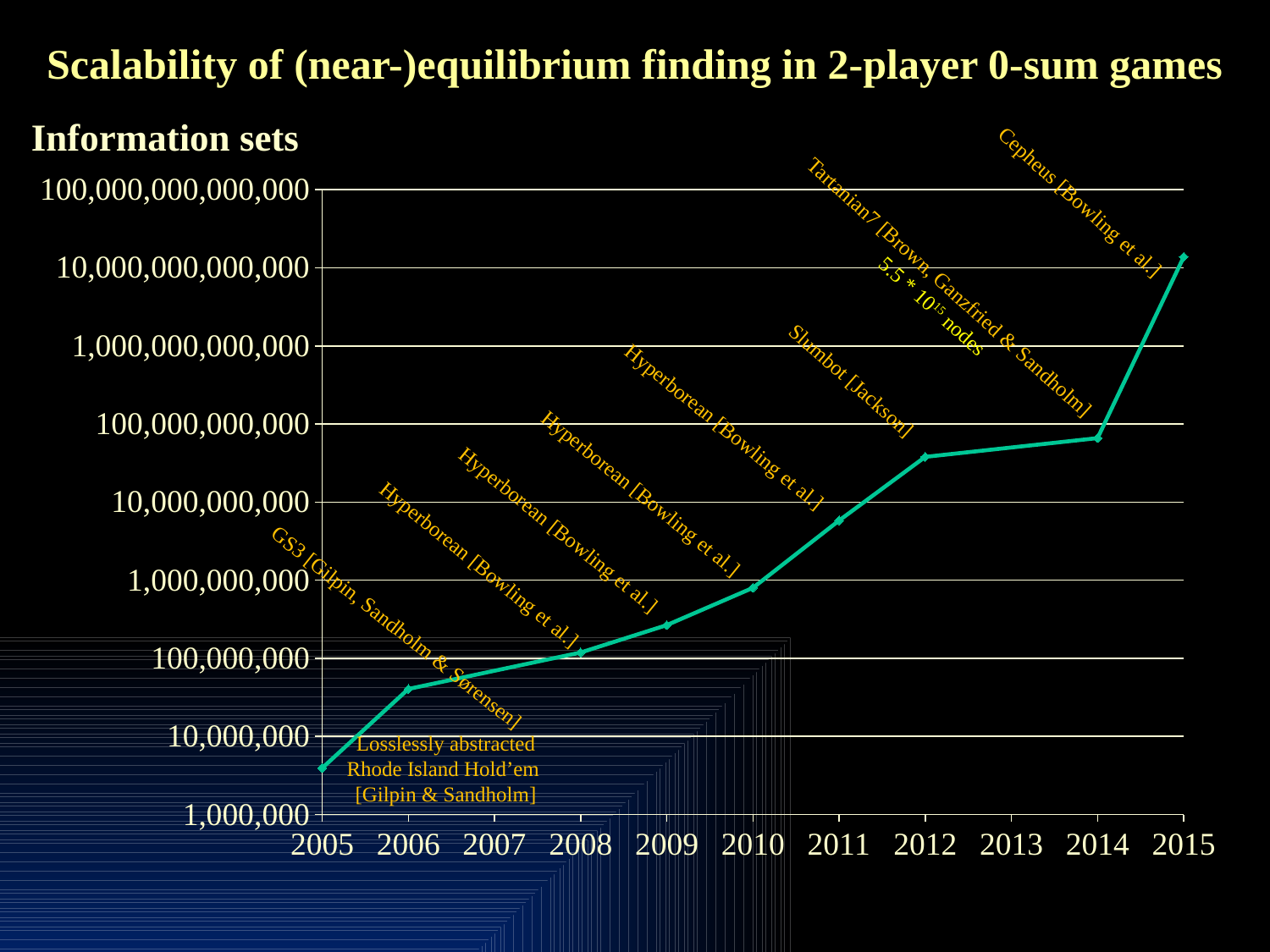
Which year has the lowest number of information sets? 2005 Is the value for 2006 greater or less than 100,000,000? less Is the value for 2009 greater or less than 100,000,000? greater What quantity is plotted on the y axis of the chart? Information sets Do the values generally rise or fall from 2005 to 2015? rise What kind of chart is shown on the slide? line chart Which year has the highest number of information sets? 2015 Which year has the larger value, 2009 or 2012? 2012 Is the value for 2005 greater or less than 10,000,000? less What is the title of the chart? Scalability of (near-)equilibrium finding in 2-player 0-sum games